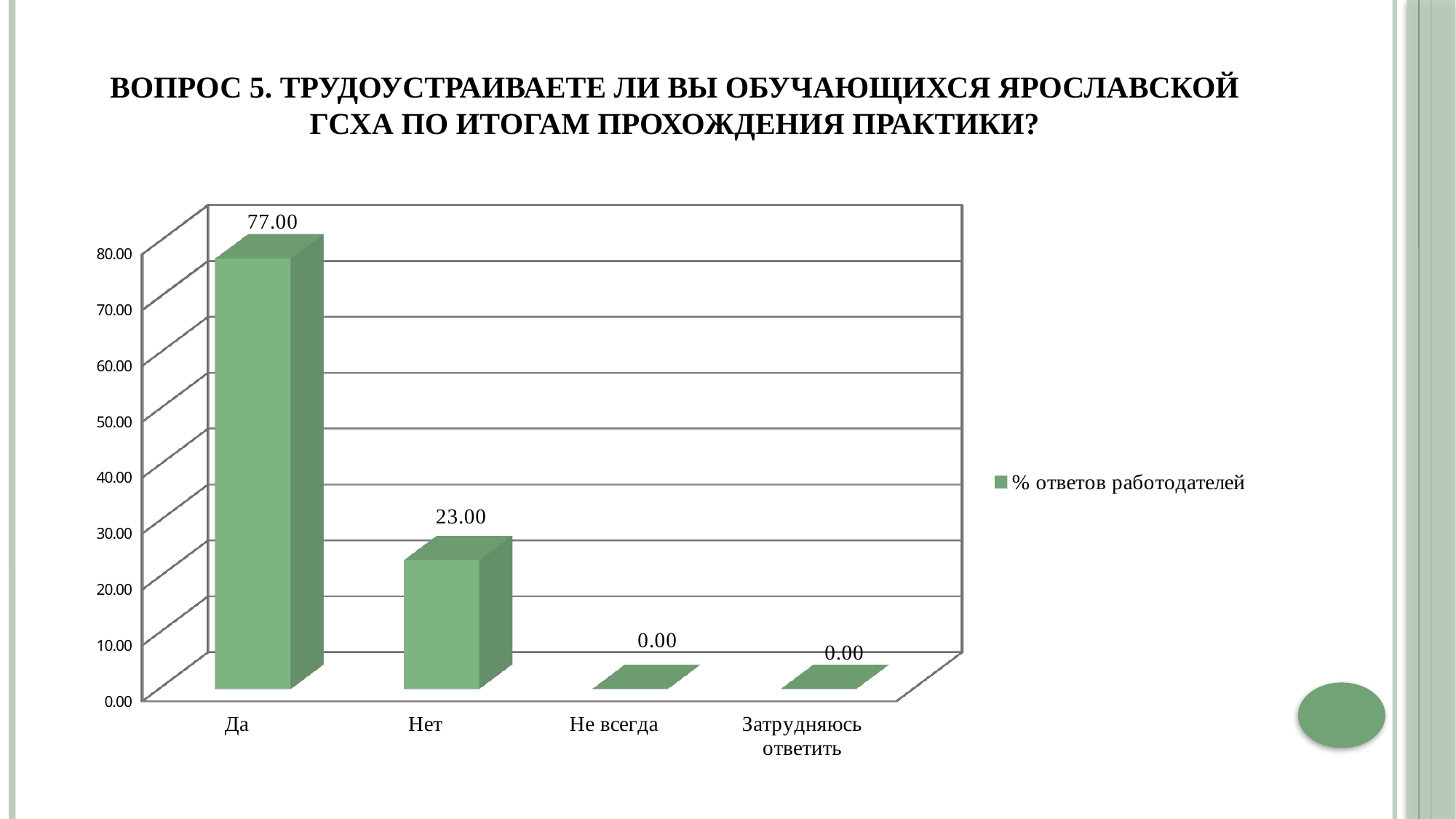
What is the value for "Затрудняюсь ответить"? 0.00 Which category has the highest value? Да What is the difference between the values for "Да" and "Нет"? 54.00 How many categories are shown on the x axis? 4 What is the value for "Нет"? 23.00 What is the legend entry for the series? % ответов работодателей What is the value for "Не всегда"? 0.00 What kind of chart is shown on the slide? bar chart What is the value for "Да"? 77.00 How many series does the legend list? 1 Is the value for "Нет" greater or less than 30.00? less Which is larger, the value for "Да" or the value for "Нет"? Да